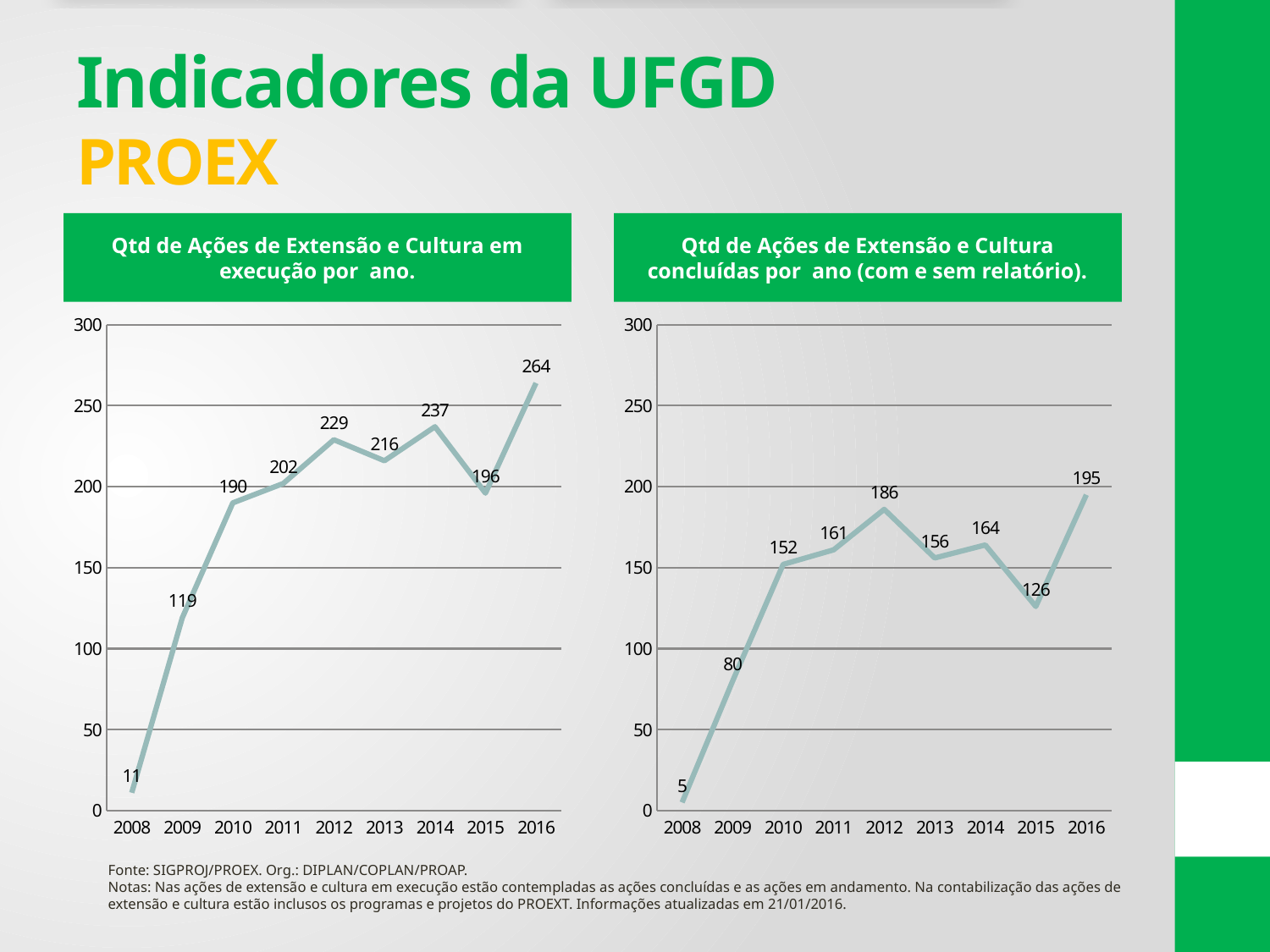
In the right chart (concluídas por ano), what is the difference between the values for 2012 and 2013? 30 In the left chart (em execução por ano), do the values generally rise or fall from 2008 to 2016? Rise In the right chart (Qtd de Ações de Extensão e Cultura concluídas por ano), what is the value for 2015? 126 In the right chart (concluídas por ano), which year has the lowest value? 2008 In the left chart (Qtd de Ações de Extensão e Cultura em execução por ano), what is the value for 2012? 229 In the left chart (em execução por ano), what is the difference between the values for 2016 and 2015? 68 In the left chart (em execução por ano), which year has the highest value? 2016 In the left chart (em execução por ano), is the value for 2010 greater or less than 150? greater What type of chart is the right chart (concluídas por ano)? Line chart How many years are plotted on the x axis of the left chart (em execução por ano)? 9 In the right chart (concluídas por ano), which is larger, the value for 2014 or the value for 2011? 2014 What is the title of the right chart? Qtd de Ações de Extensão e Cultura concluídas por ano (com e sem relatório).